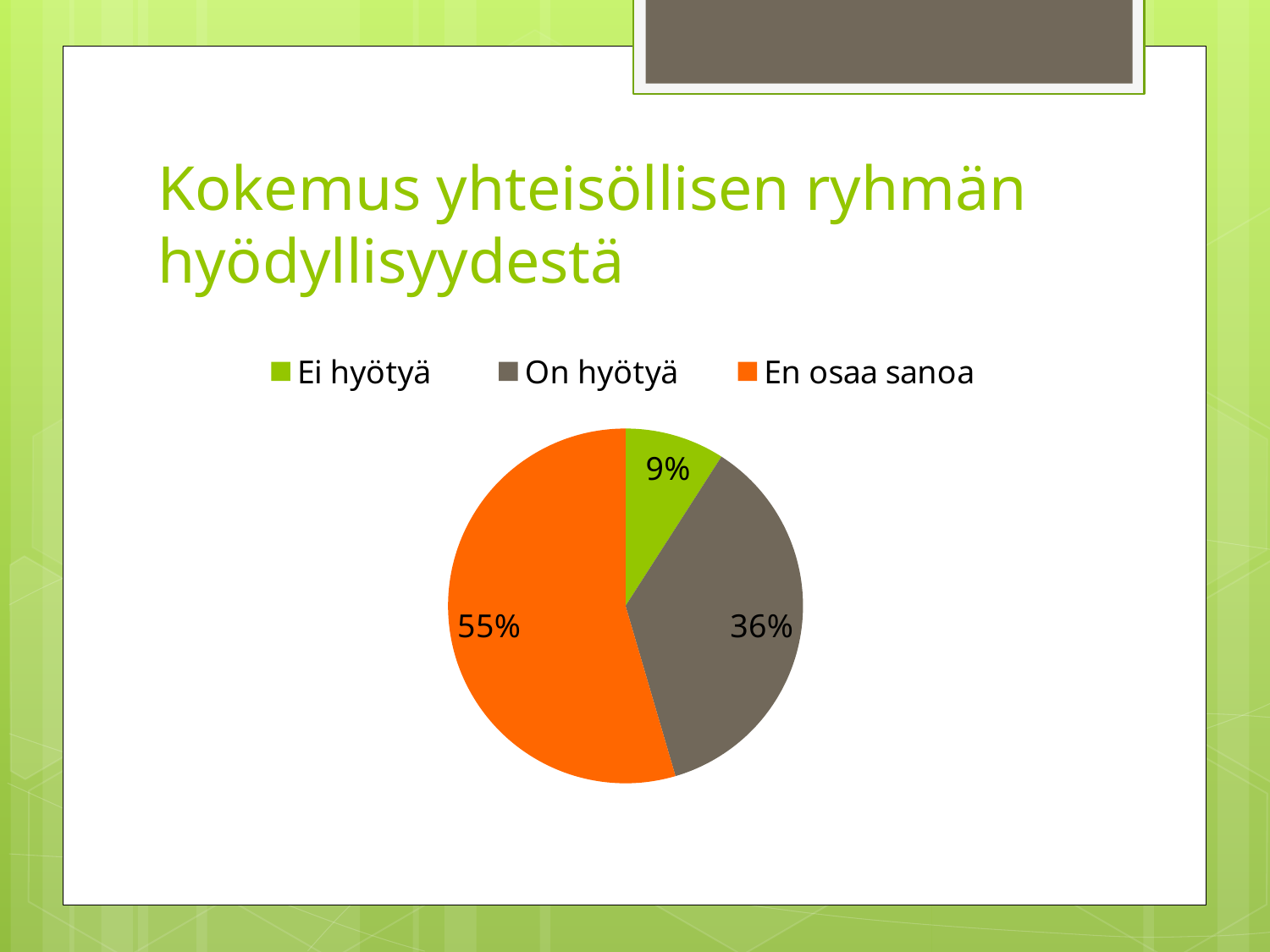
What is the difference in percentage points between "On hyötyä" and "Ei hyötyä"? 27 What share of the pie does "En osaa sanoa" represent? 55% What kind of chart is shown on the slide? pie chart How many entries does the legend list? 3 How many slices does the pie chart have? 3 What share of the pie does "Ei hyötyä" represent? 9% Which is larger, the slice for "On hyötyä" or the slice for "Ei hyötyä"? On hyötyä What is the difference in percentage points between "En osaa sanoa" and "On hyötyä"? 19 Which category has the smallest slice of the pie? Ei hyötyä What colour is the slice for "En osaa sanoa"? orange Which category has the largest slice of the pie? En osaa sanoa What share of the pie does "On hyötyä" represent? 36%